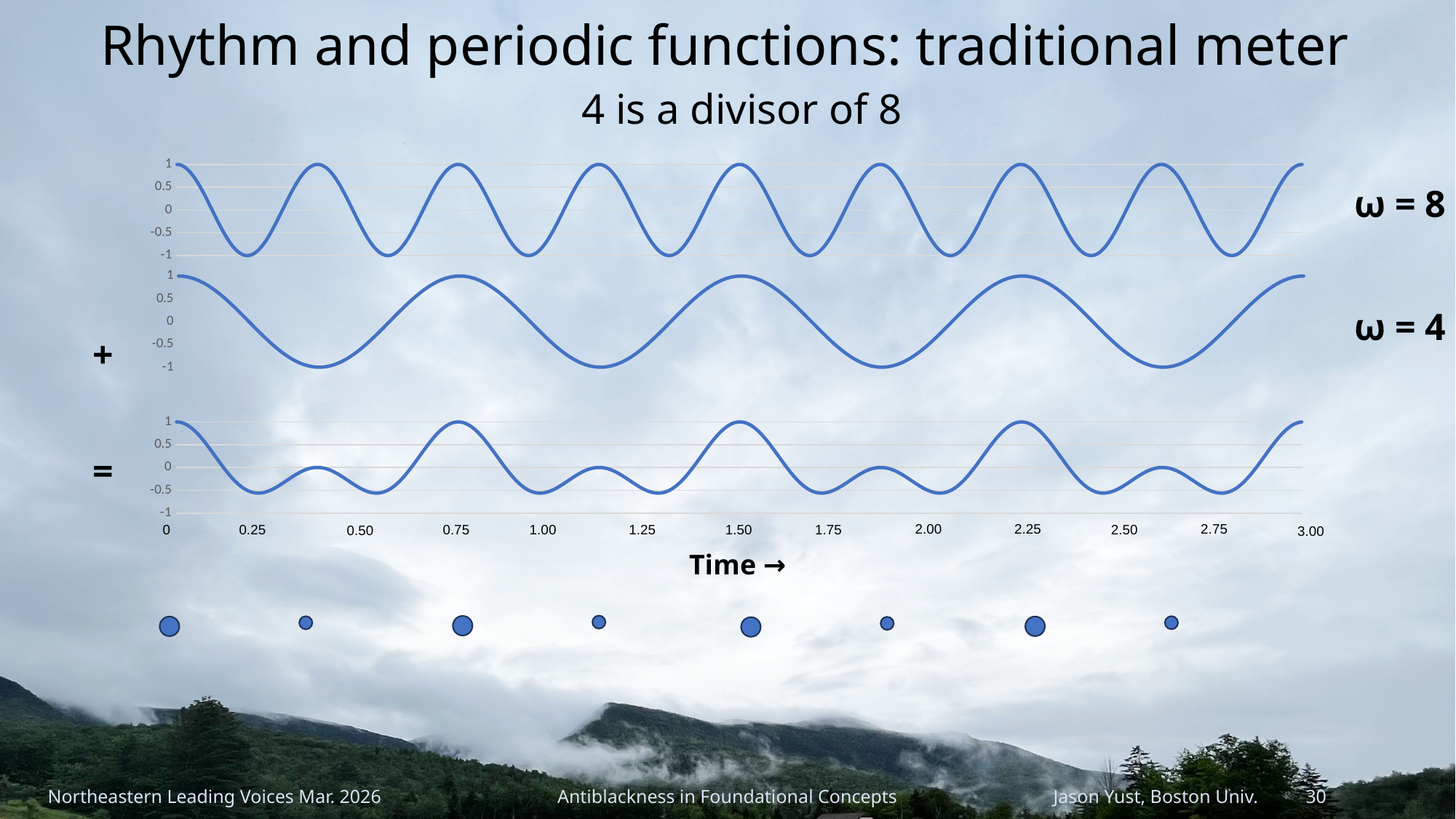
What is the label on the x axis of the bottom chart? Time → In the middle chart (ω = 4), what is the lowest value reached by the curve? -1 What label is shown to the right of the top chart? ω = 8 How many separate charts are stacked on the slide? 3 In the bottom chart, what is the value at time 1.50? 1 How many peaks does the curve in the middle chart (ω = 4) have between time 0 and 3.00, inclusive? 5 In the middle chart (ω = 4), what is the value at time 0.75? 1 How many peaks does the curve in the top chart (ω = 8) have between time 0 and 3.00, inclusive? 9 In the top chart (ω = 8), what is the highest value reached by the curve? 1 In the top chart (ω = 8), what is the value at time 0? 1 What is the largest value shown on the x axis of the bottom chart? 3.00 What kind of chart is used for the three plots on this slide? line chart